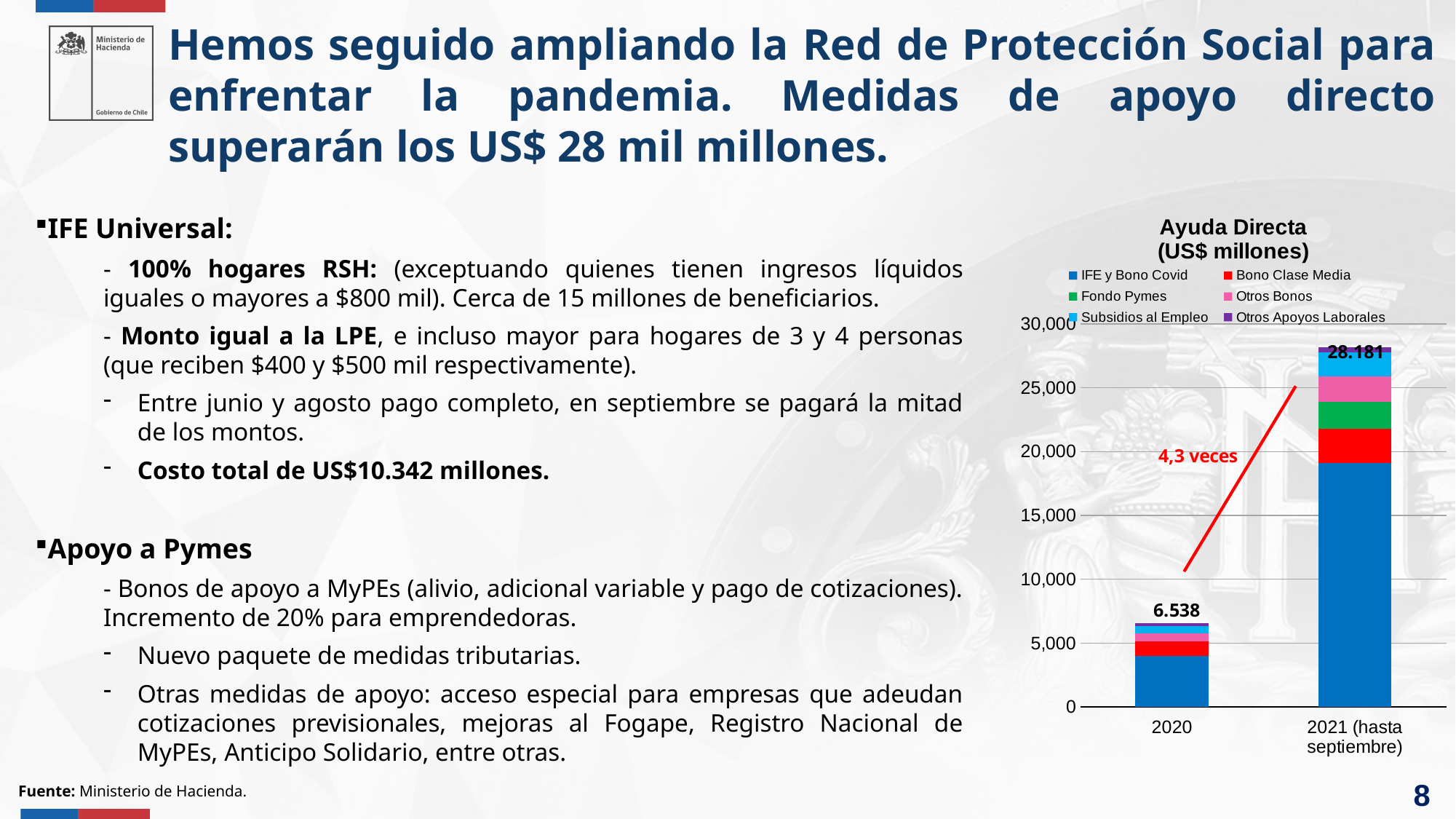
Which category has the highest total in the Ayuda Directa chart? 2021 (hasta septiembre) What kind of chart is the Ayuda Directa chart? Stacked bar chart How many categories are shown on the x axis of the Ayuda Directa chart? 2 Is the IFE y Bono Covid segment for 2020 greater or less than 5,000? less What is the total value of the 2021 (hasta septiembre) bar in the Ayuda Directa chart? 28.181 Which category has the lowest total in the Ayuda Directa chart? 2020 What is the total value of the 2020 bar in the Ayuda Directa chart? 6.538 Which is larger in the Ayuda Directa chart, the 2020 total or the 2021 (hasta septiembre) total? 2021 (hasta septiembre) What multiplier does the red annotation in the Ayuda Directa chart show between 2020 and 2021? 4,3 veces How many series does the legend of the Ayuda Directa chart list? 6 What is the difference between the 2021 (hasta septiembre) total and the 2020 total in the Ayuda Directa chart? 21.643 Is the IFE y Bono Covid segment for 2021 (hasta septiembre) greater or less than 15,000? greater